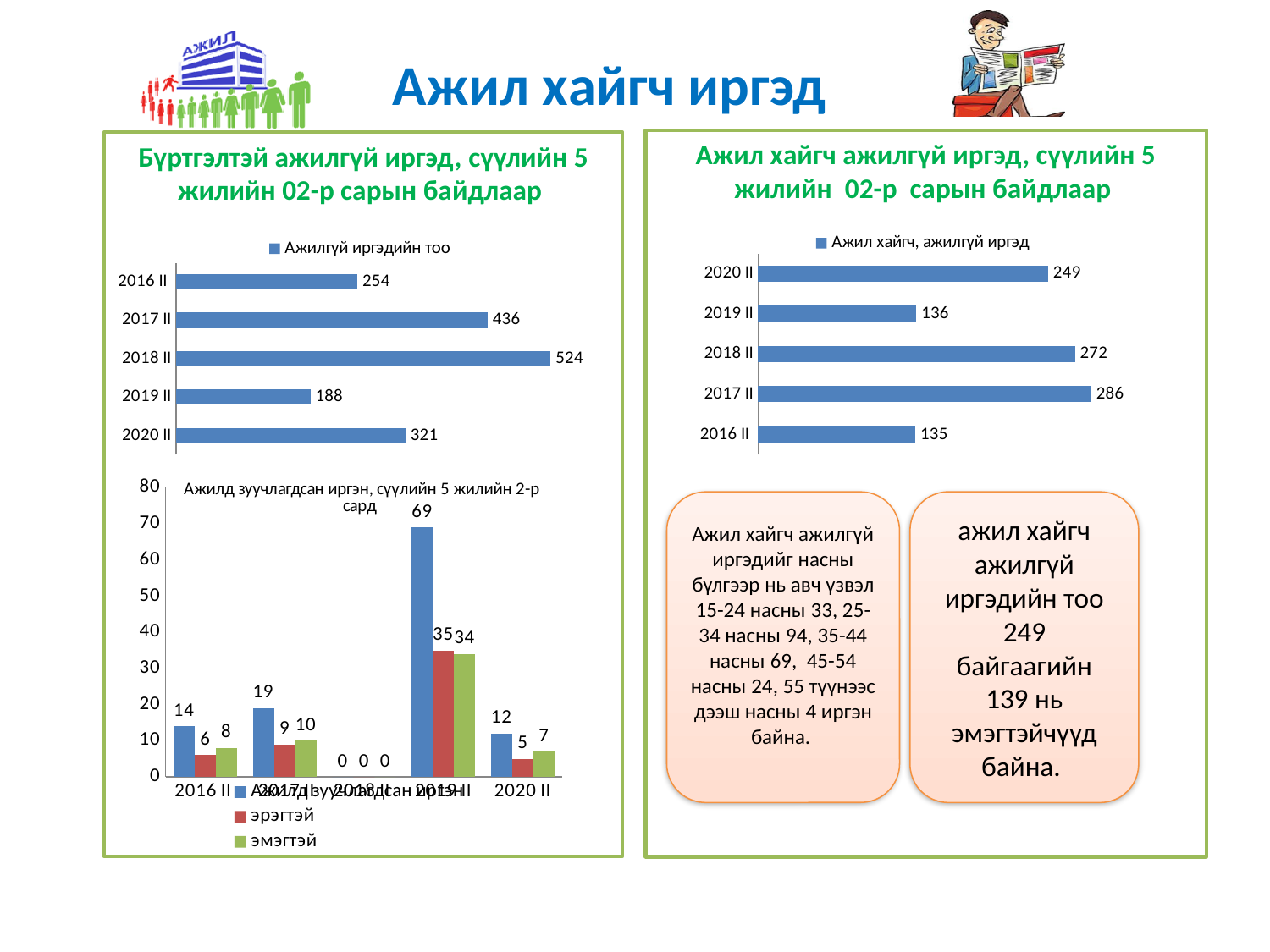
In the chart titled 'Ажилгүй иргэдийн тоо' (top-left), how many categories are shown? 5 In the chart titled 'Ажил хайгч, ажилгүй иргэд' (top-right), which year has the highest value? 2017 II In the chart titled 'Ажилгүй иргэдийн тоо' (top-left), what is the value for 2018 II? 524 In the chart titled 'Ажилгүй иргэдийн тоо' (top-left), which year has the lowest value? 2019 II In the chart titled 'Ажил хайгч, ажилгүй иргэд' (top-right), what is the value for 2019 II? 136 In the chart titled 'Ажилд зуучлагдсан иргэн, сүүлийн 5 жилийн 2-р сард' (bottom-left), what is the difference between 'эмэгтэй' and 'эрэгтэй' for 2016 II? 2 In the chart titled 'Ажил хайгч, ажилгүй иргэд' (top-right), which is larger: the value for 2020 II or 2018 II? 2018 II In the chart titled 'Ажилд зуучлагдсан иргэн, сүүлийн 5 жилийн 2-р сард' (bottom-left), what is the value of 'эрэгтэй' for 2019 II? 35 In the chart titled 'Ажилд зуучлагдсан иргэн, сүүлийн 5 жилийн 2-р сард' (bottom-left), which year has the highest value for 'Ажилд зуучлагдсан иргэн'? 2019 II What type of chart is the chart titled 'Ажил хайгч, ажилгүй иргэд' (top-right)? Bar chart In the chart titled 'Ажилгүй иргэдийн тоо' (top-left), what is the difference between the values for 2017 II and 2016 II? 182 In the chart titled 'Ажилд зуучлагдсан иргэн, сүүлийн 5 жилийн 2-р сард' (bottom-left), how many series does the legend list? 3